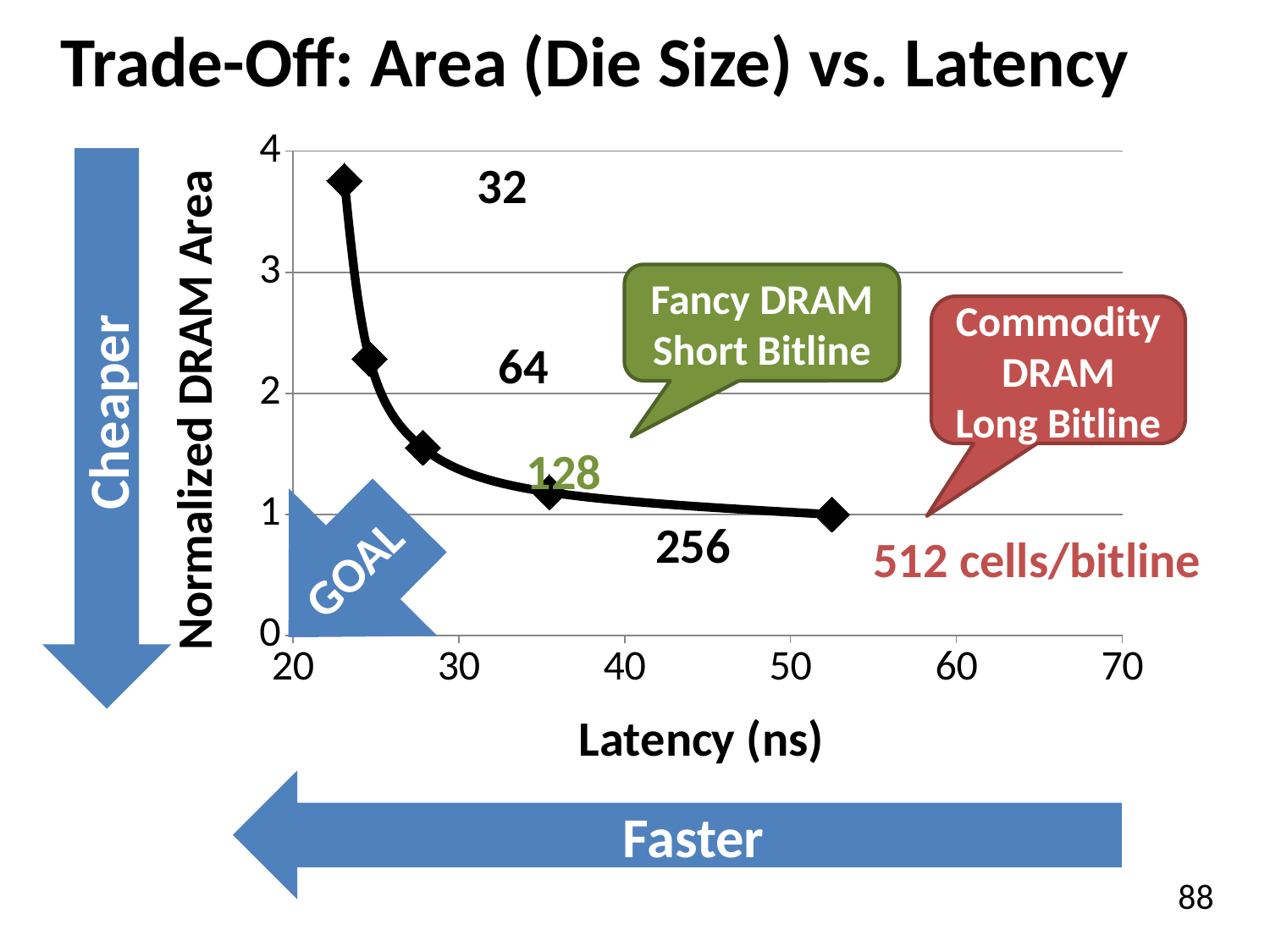
As latency increases along the x axis, does the normalized DRAM area rise or fall? fall Is the normalized DRAM area for 128 cells/bitline greater or less than 2? less What kind of chart is shown on the slide? line chart Which has a larger normalized DRAM area, 32 cells/bitline or 64 cells/bitline? 32 cells/bitline Which cells/bitline configuration has the highest normalized DRAM area? 32 Is the normalized DRAM area for 64 cells/bitline greater or less than 2? greater Is the normalized DRAM area for 32 cells/bitline greater or less than 3? greater How many data points are plotted on the chart? 5 Which cells/bitline configuration has the highest latency? 512 Which cells/bitline configuration has the lowest latency? 32 What is the title of the x axis? Latency (ns)